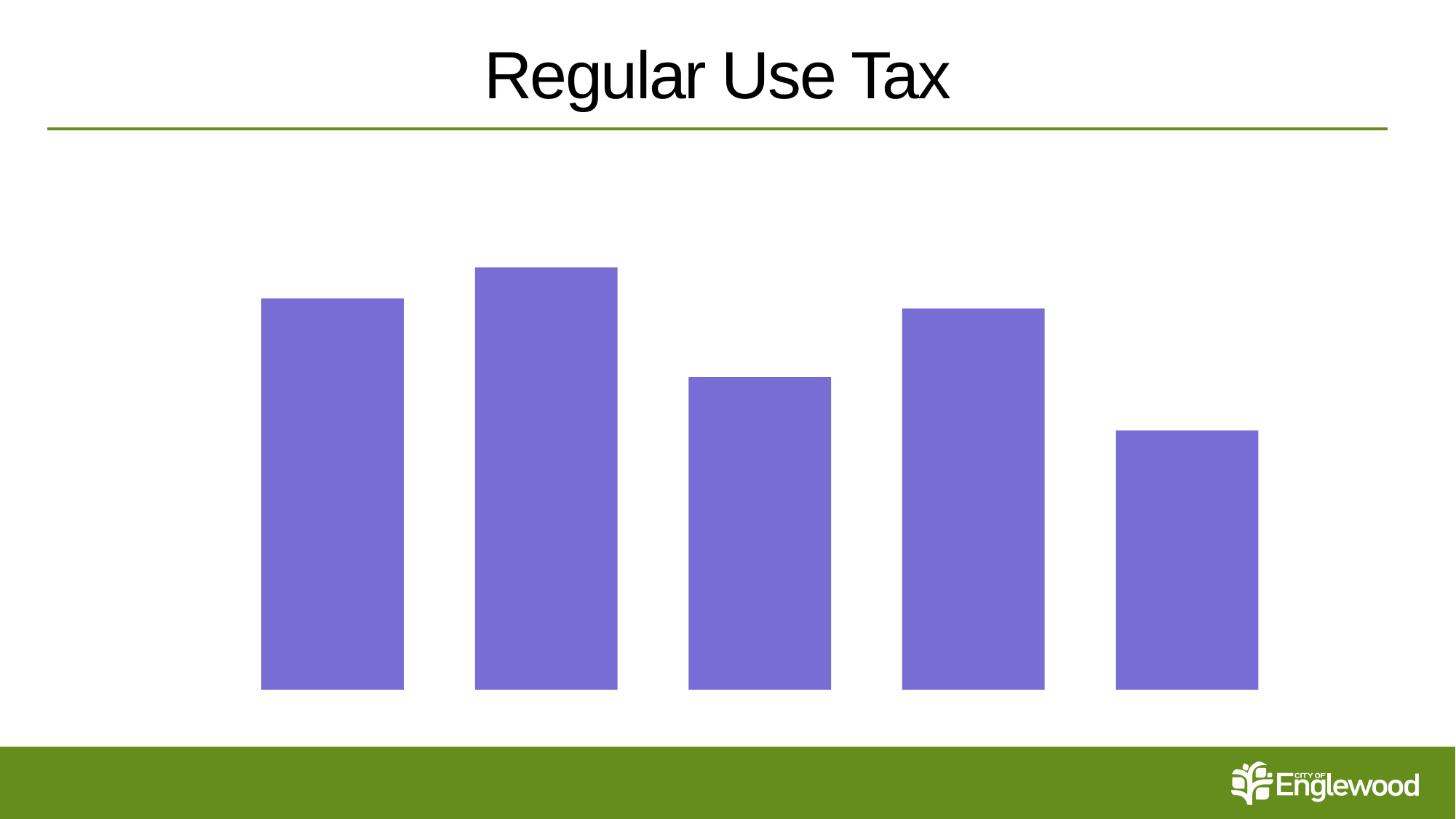
Which is taller, the first bar or the third bar from the left? the first bar Which is taller, the second bar or the fourth bar from the left? the second bar What colour are the bars in the chart? purple How many bars does the chart show? 5 Which bar is the shortest, counting from the left? the fifth (rightmost) bar Which is taller, the fourth bar or the fifth bar from the left? the fourth bar Which bar is the tallest, counting from the left? the second bar What kind of chart is shown on the slide? bar chart What is the title of the slide containing the chart? Regular Use Tax